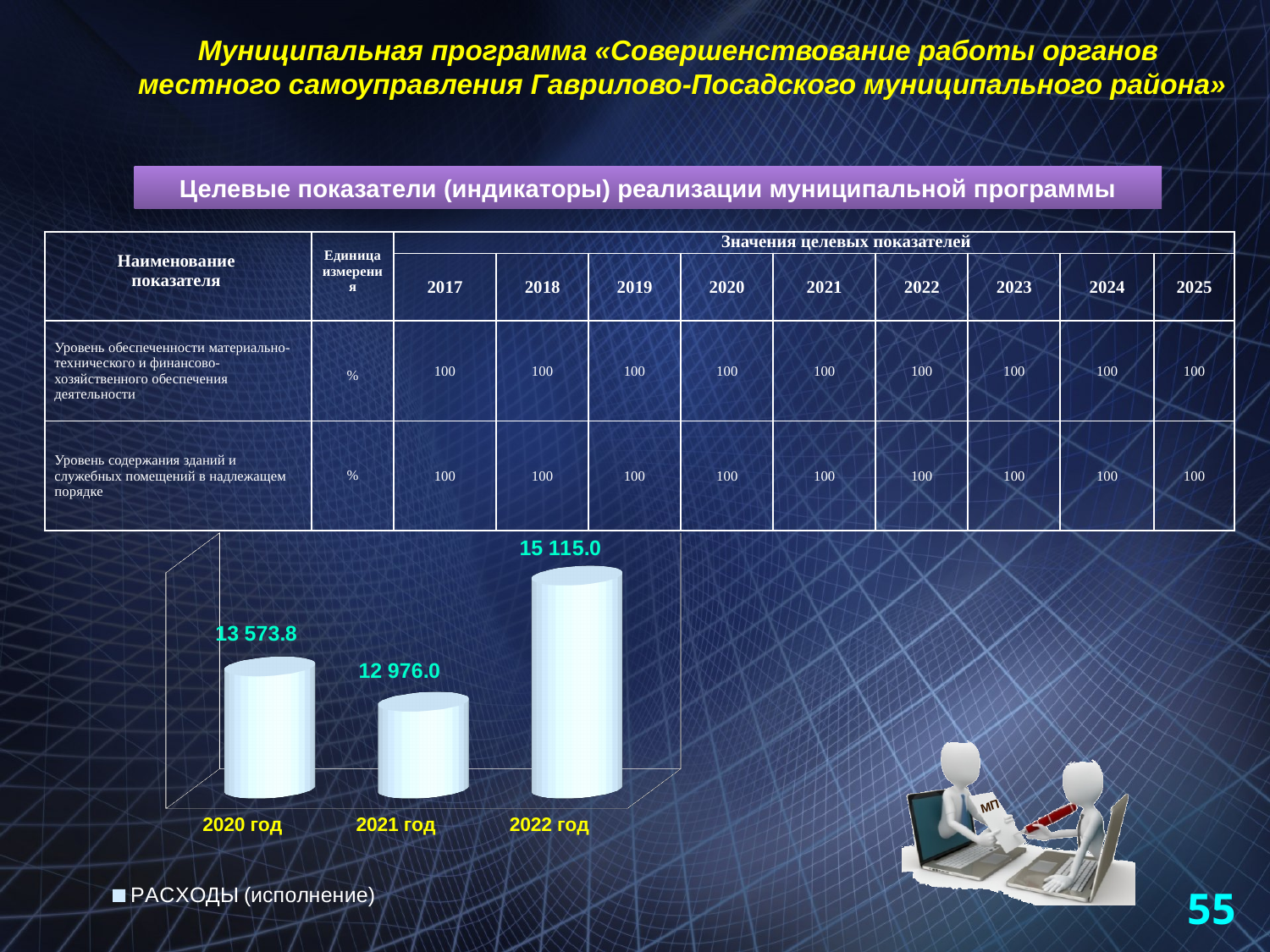
Which year has the highest value in the bar chart? 2022 год How many bars are shown in the bar chart? 3 What is the value for 2021 год in the bar chart? 12 976.0 What is the value for 2020 год in the bar chart? 13 573.8 What is the difference between the values for 2020 год and 2021 год in the bar chart? 597.8 Which is larger in the bar chart, the value for 2020 год or 2021 год? 2020 год What is the difference between the values for 2022 год and 2020 год in the bar chart? 1 541.2 Which year has the lowest value in the bar chart? 2021 год What kind of chart is shown at the bottom of the slide? bar chart What is the value for 2022 год in the bar chart? 15 115.0 What is the legend entry of the bar chart? РАСХОДЫ (исполнение) How many series does the legend of the bar chart list? 1